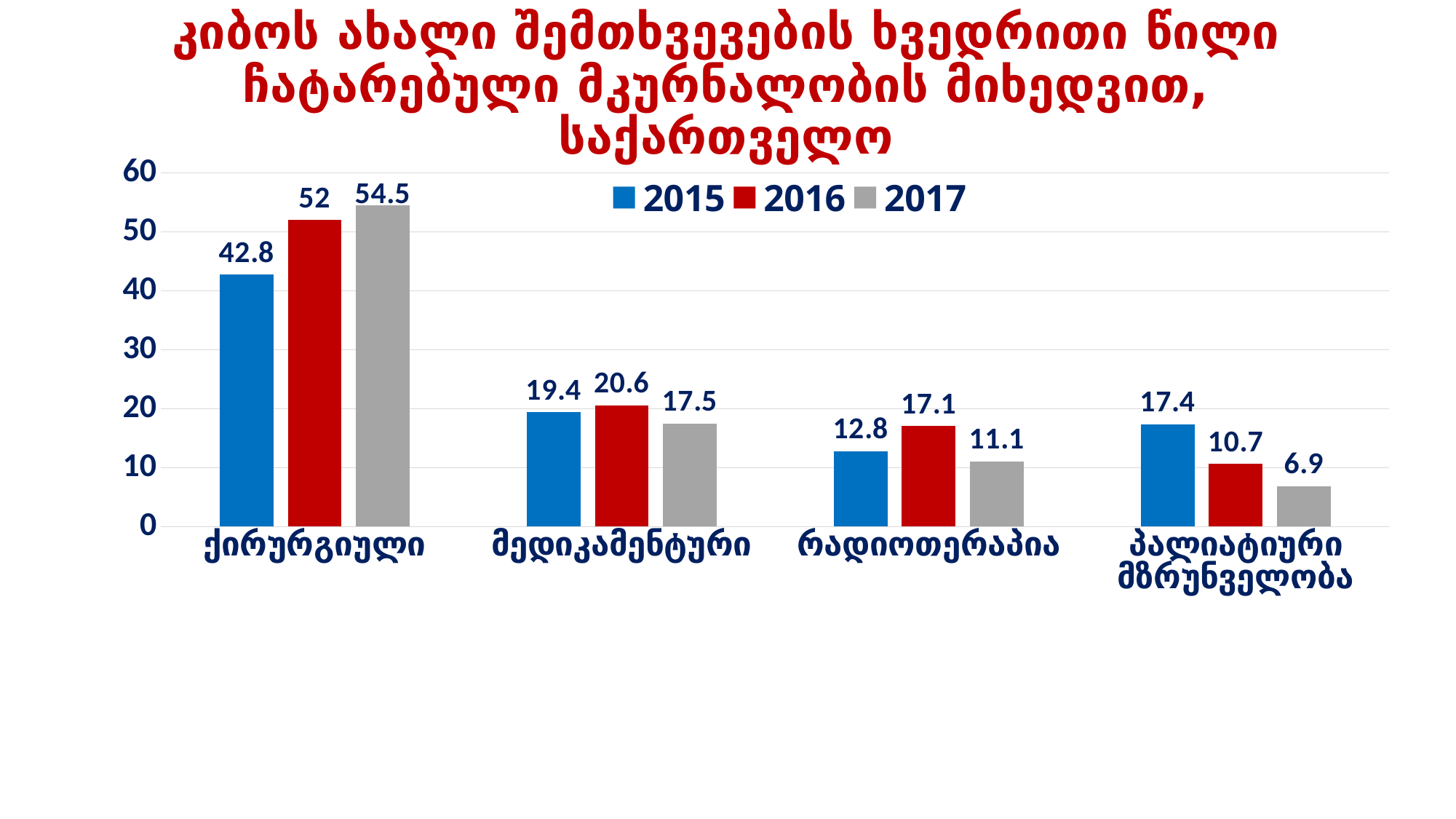
How many categories are shown on the x axis? 4 Which is larger for მედიკამენტური: the 2015 value or the 2017 value? 2015 What is the 2015 value for რადიოთერაპია? 12.8 What is the 2016 value for პალიატიური მზრუნველობა? 10.7 Which category has the highest 2016 value? ქირურგიული How many series does the legend list? 3 Do the values for პალიატიური მზრუნველობა rise or fall from 2015 to 2017? fall Which category has the lowest 2017 value? პალიატიური მზრუნველობა What is the difference between the 2017 and 2015 values for ქირურგიული? 11.7 Is the 2016 value for ქირურგიული greater or less than 50? greater What is the 2017 value for ქირურგიული? 54.5 What kind of chart is shown on the slide? bar chart